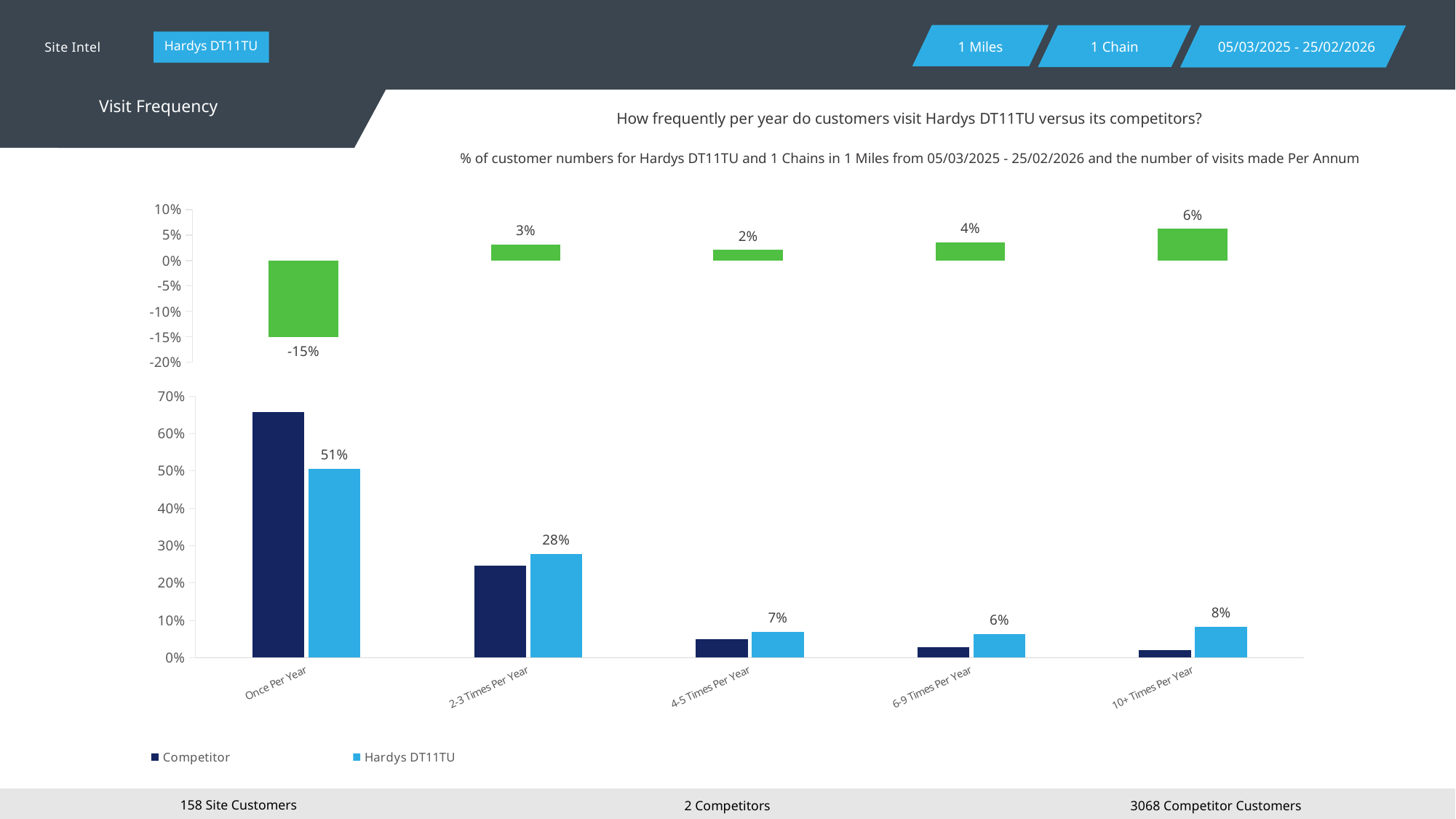
In the bottom chart, what is the difference between the Hardys DT11TU values for Once Per Year and 2-3 Times Per Year? 23% In the bottom chart, what is the value for Hardys DT11TU in the Once Per Year category? 51% In the bottom chart, which category has the lowest value for Hardys DT11TU? 6-9 Times Per Year In the bottom chart, is the Competitor value for Once Per Year greater or less than 60%? greater What kind of chart is the bottom chart? bar chart How many series does the legend of the bottom chart list? 2 In the bottom chart, what is the value for Hardys DT11TU in the 2-3 Times Per Year category? 28% In the top chart, which category has the lowest value? Once Per Year How many categories are shown on the x axis of the bottom chart? 5 In the top chart, what is the value for Once Per Year? -15% In the bottom chart, which series has the larger value for Once Per Year, Competitor or Hardys DT11TU? Competitor In the top chart, which category has the highest value? 10+ Times Per Year